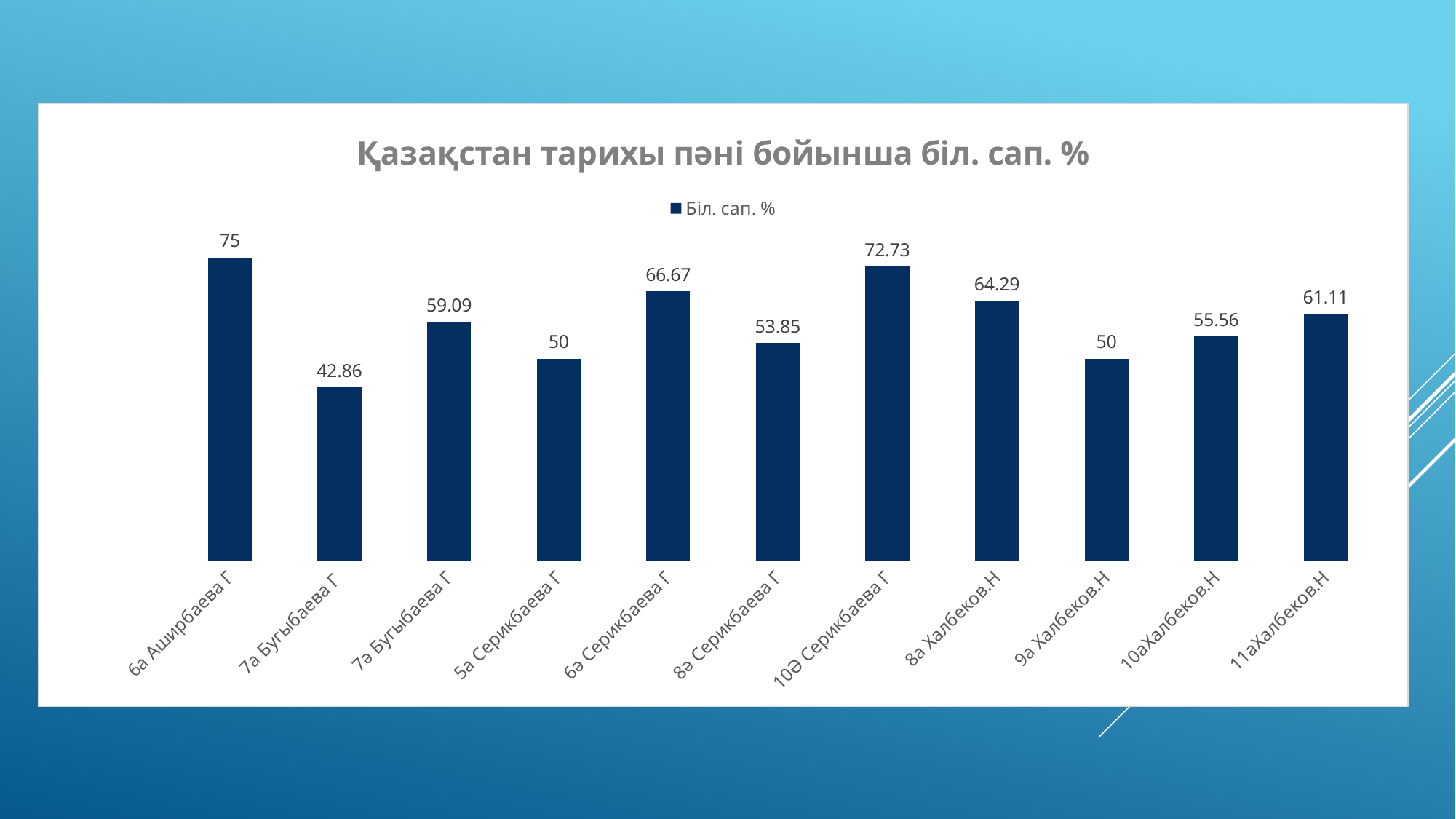
How many categories are shown on the chart? 11 What is the value for 6а Аширбаева Г? 75 Which category has the lowest value? 7а Бугыбаева Г How many series does the legend list? 1 Which category has the highest value? 6а Аширбаева Г What kind of chart is shown? bar chart What is the value for 7а Бугыбаева Г? 42.86 What is the value for 10Ә Серикбаева Г? 72.73 Which is larger, the value for 6ә Серикбаева Г or the value for 8а Халбеков.Н? 6ә Серикбаева Г What is the value for 11аХалбеков.Н? 61.11 What is the title of the chart? Қазақстан тарихы пәні бойынша біл. сап. % What is the difference between the values for 6а Аширбаева Г and 7а Бугыбаева Г? 32.14